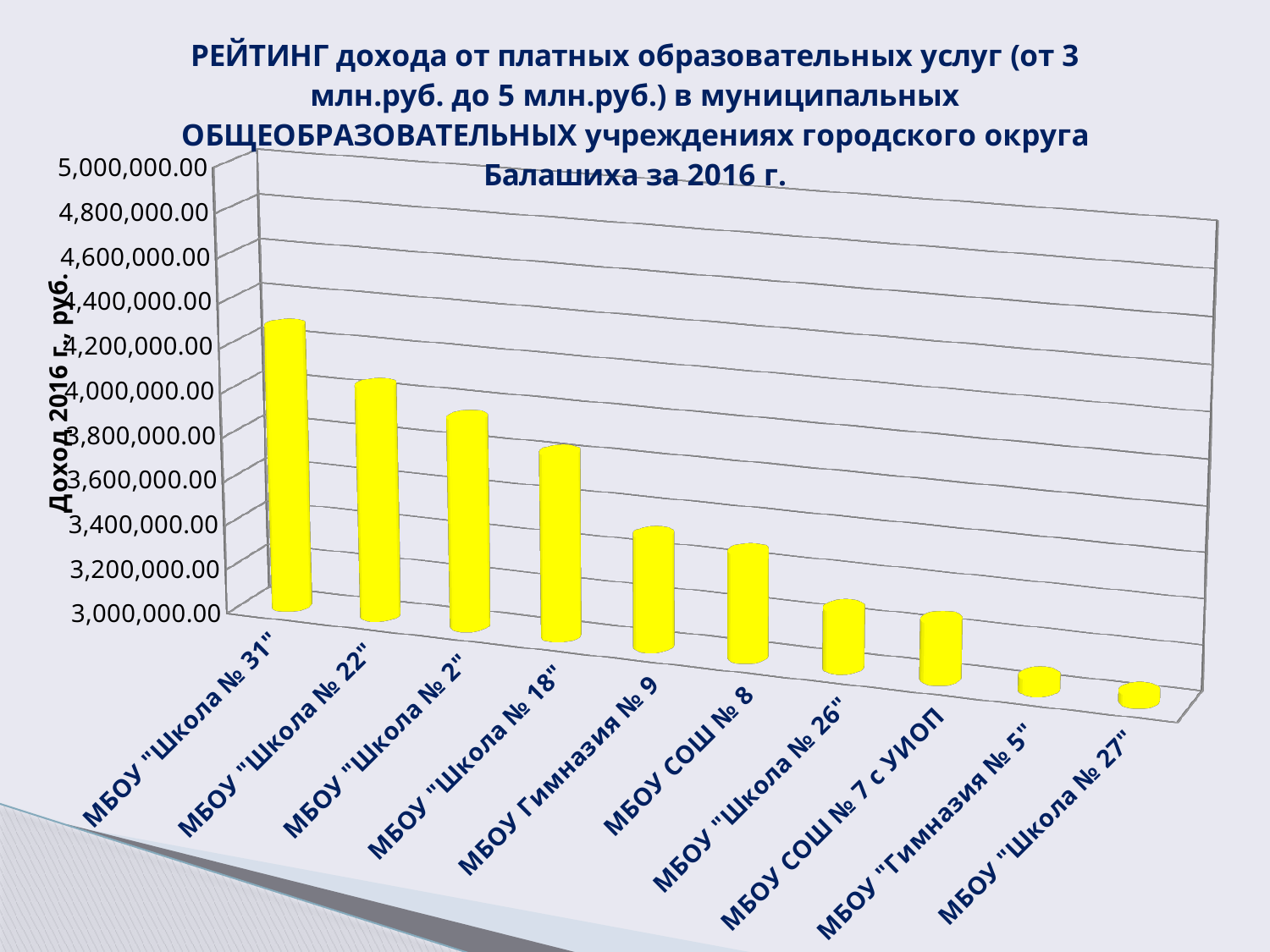
Is the value for МБОУ "Школа № 22" greater or less than 3,800,000.00? greater What kind of chart is shown on the slide? bar chart Is the value for МБОУ "Школа № 2" greater or less than 3,600,000.00? greater Is the value for МБОУ "Школа № 27" greater or less than 3,400,000.00? less Which is larger, the value for МБОУ "Школа № 18" or for МБОУ Гимназия № 9? МБОУ "Школа № 18" Which school has the highest income on the chart? МБОУ "Школа № 31" How many schools (categories) are shown on the chart? 10 Do the values rise or fall from left to right along the x axis? fall What is the title of the vertical axis? Доход 2016 г., руб.